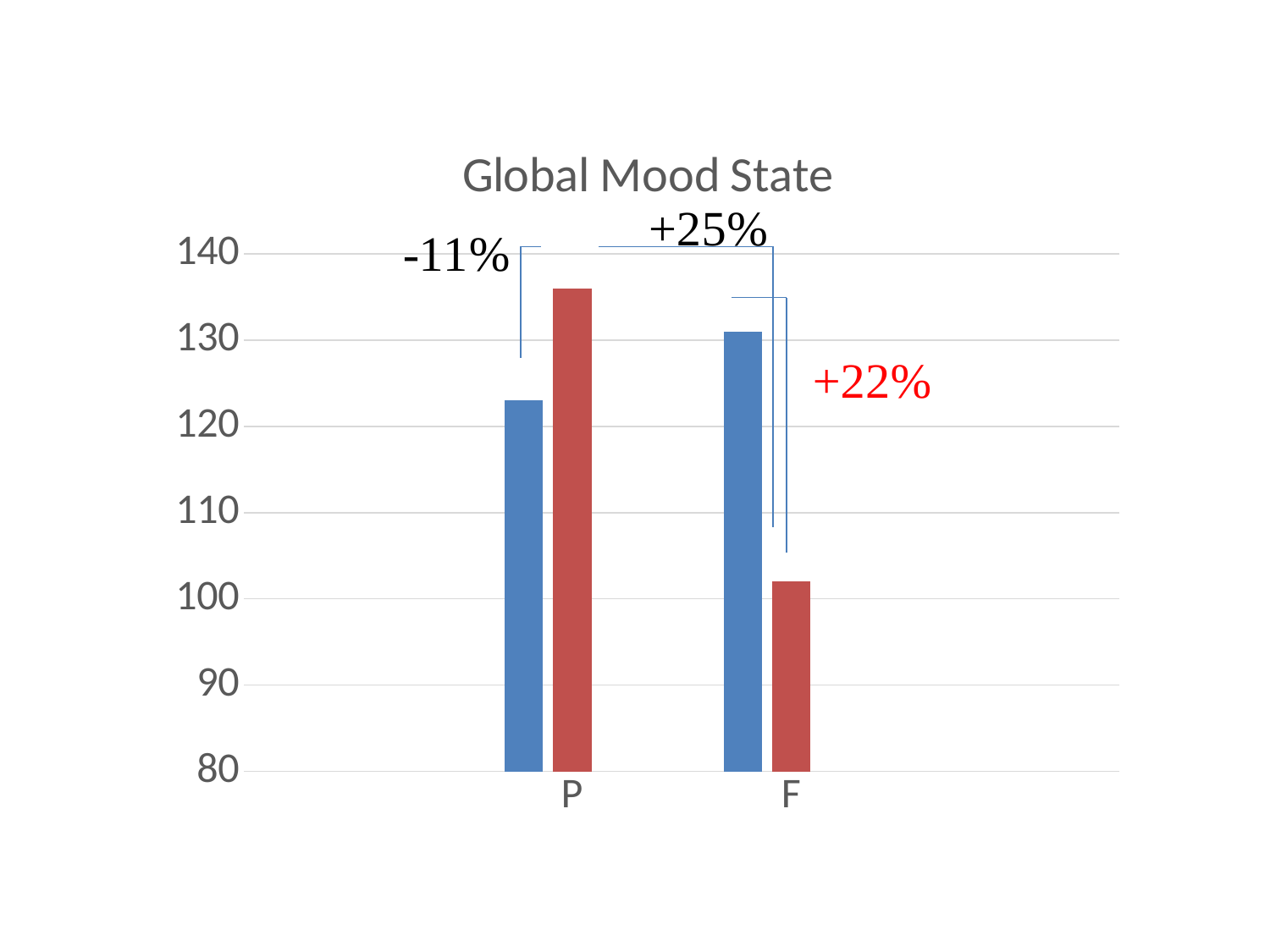
How many categories are shown on the x axis of the chart? 2 Is the value of the blue bar for F greater or less than 120? greater Is the value of the blue bar for P greater or less than 120? greater What is the lowest value shown on the vertical axis of the chart? 80 Is the value of the red bar for P greater or less than 130? greater What is the title of the chart? Global Mood State Which bar is the tallest in the chart? the red bar for P What kind of chart is shown on the slide? bar chart For category F, which bar is taller, the blue bar or the red bar? the blue bar For category P, which bar is taller, the blue bar or the red bar? the red bar Which bar is the shortest in the chart? the red bar for F